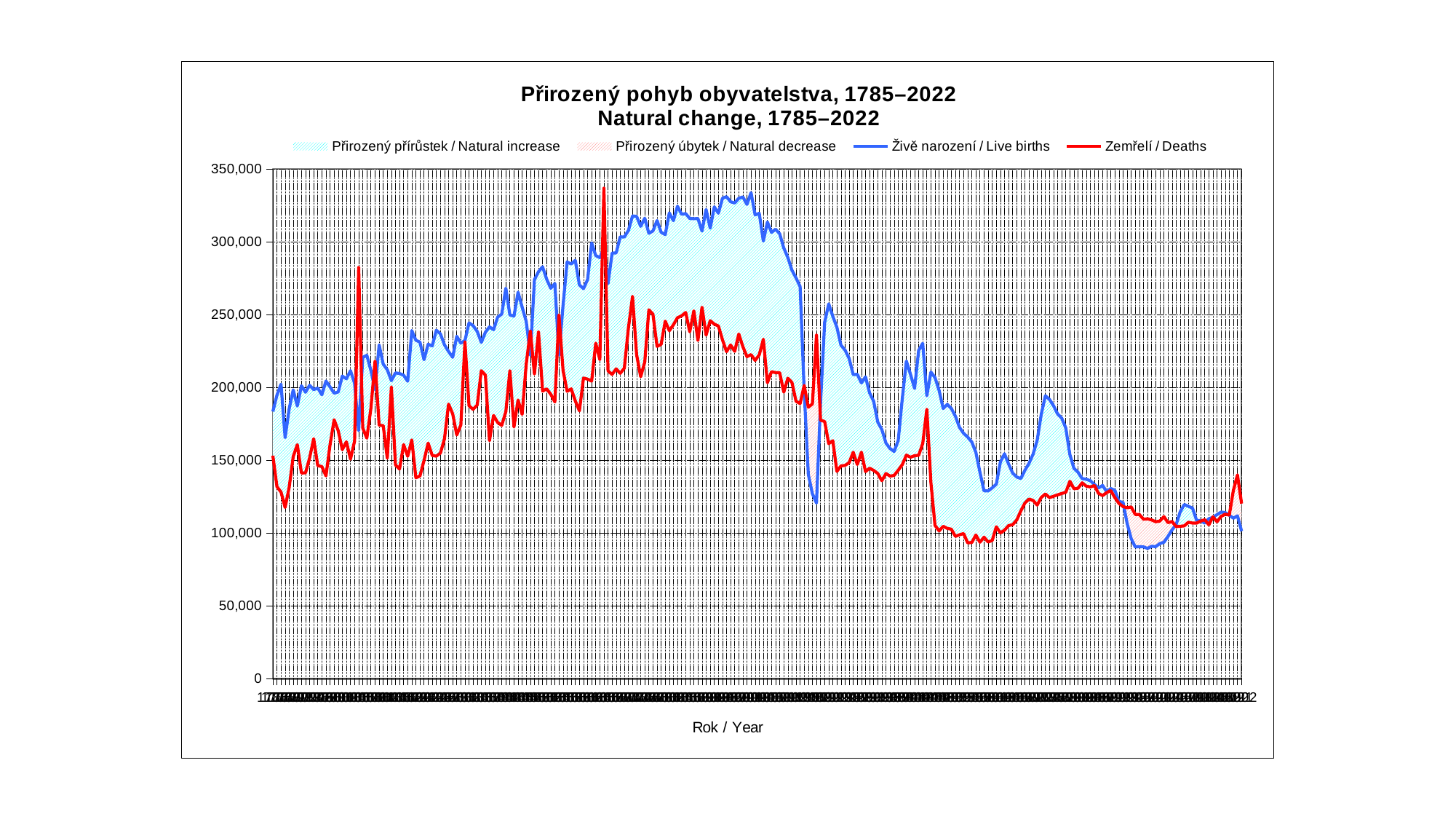
What is the label of the x axis? Rok / Year How many series does the legend list? 4 At the end of the period (2022), which series is higher: Live births or Deaths? Deaths Is the value for Live births (Živě narození) in 2022 greater or less than 150,000? less Is the value for Live births in 1785 greater or less than 150,000? greater Does the Live births series end higher or lower in 2022 than it started in 1785? lower What kind of chart is shown on the slide? combination area and line chart Does the Deaths series ever rise above 300,000? yes What is the English part of the chart title? Natural change, 1785–2022 How many years does the chart cover, from 1785 to 2022 inclusive? 238